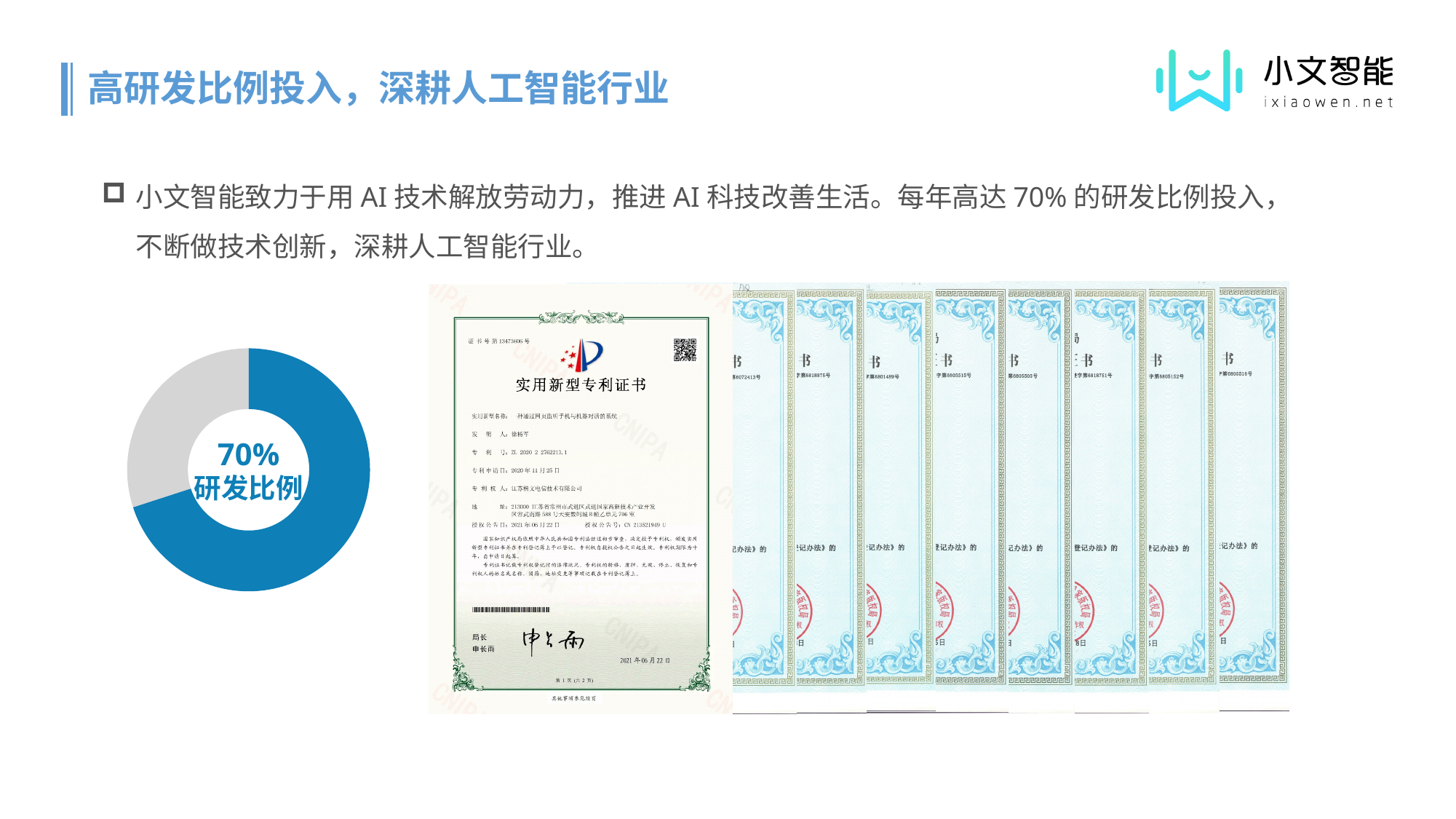
What colour is the slice representing the 70% R&D ratio in the doughnut chart? Blue Is the blue slice of the doughnut chart greater or less than half of the whole? greater What does the 70% in the doughnut chart refer to, according to the label in its centre? 研发比例 What kind of chart is shown on the left of the slide? Doughnut (pie) chart How many slices does the doughnut chart have? 2 What text is printed in the centre of the doughnut chart? 70% 研发比例 Which slice of the doughnut chart is larger, the blue one or the grey one? The blue one What percentage does the blue slice of the doughnut chart represent? 70%